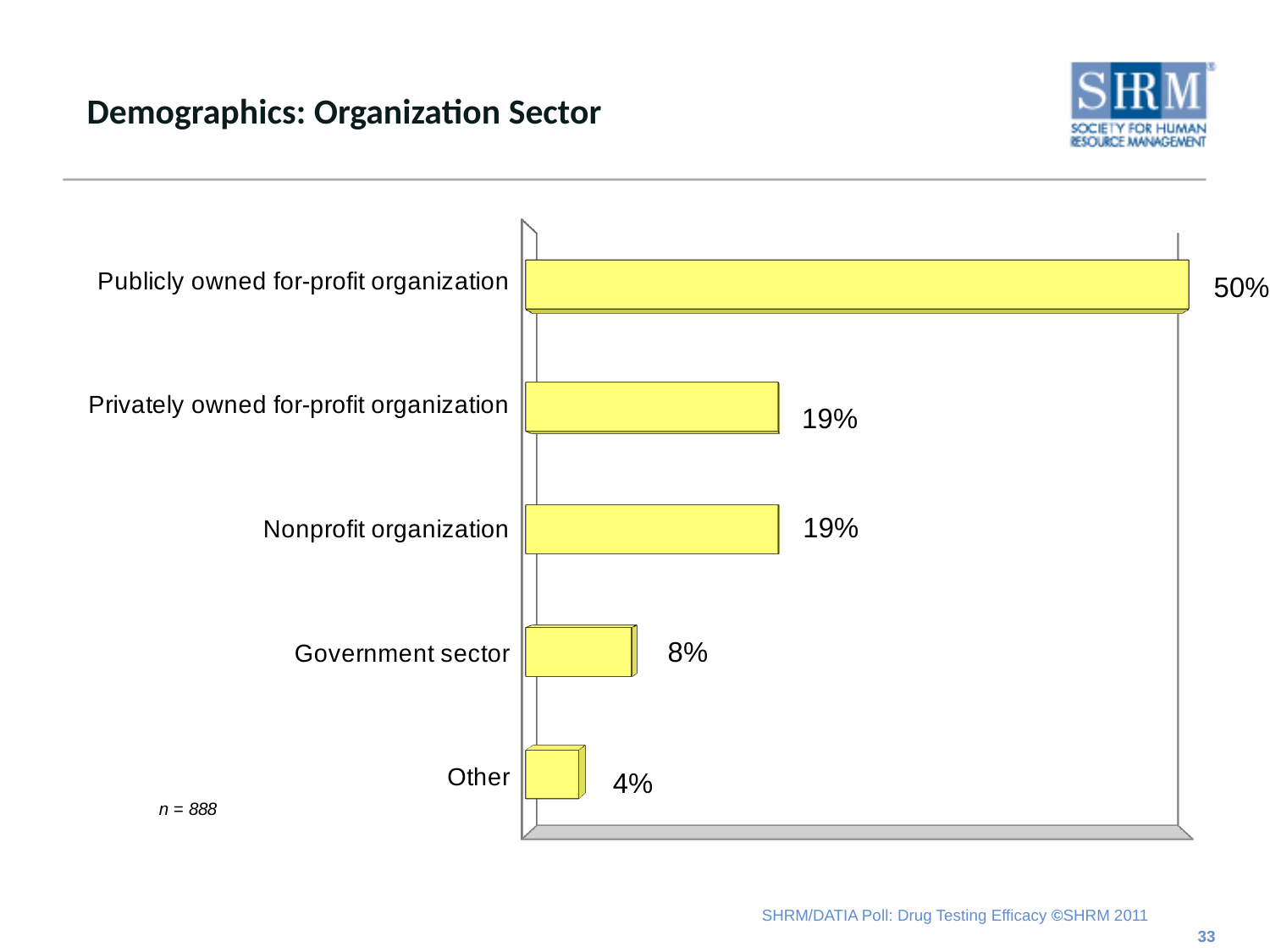
What is the value for Nonprofit organization? 19% What is the difference between the values for Government sector and Other? 4% Which organization sector has the highest percentage? Publicly owned for-profit organization What is the difference between the values for Publicly owned for-profit organization and Privately owned for-profit organization? 31% Which is larger, the value for Government sector or the value for Nonprofit organization? Nonprofit organization What is the sample size (n) noted on the slide? n = 888 Which organization sector has the lowest percentage? Other What is the value for Government sector? 8% What is the value for Other? 4% What kind of chart is shown on the slide? Bar chart How many organization sector categories are shown in the chart? 5 What percentage of respondents are from a publicly owned for-profit organization? 50%